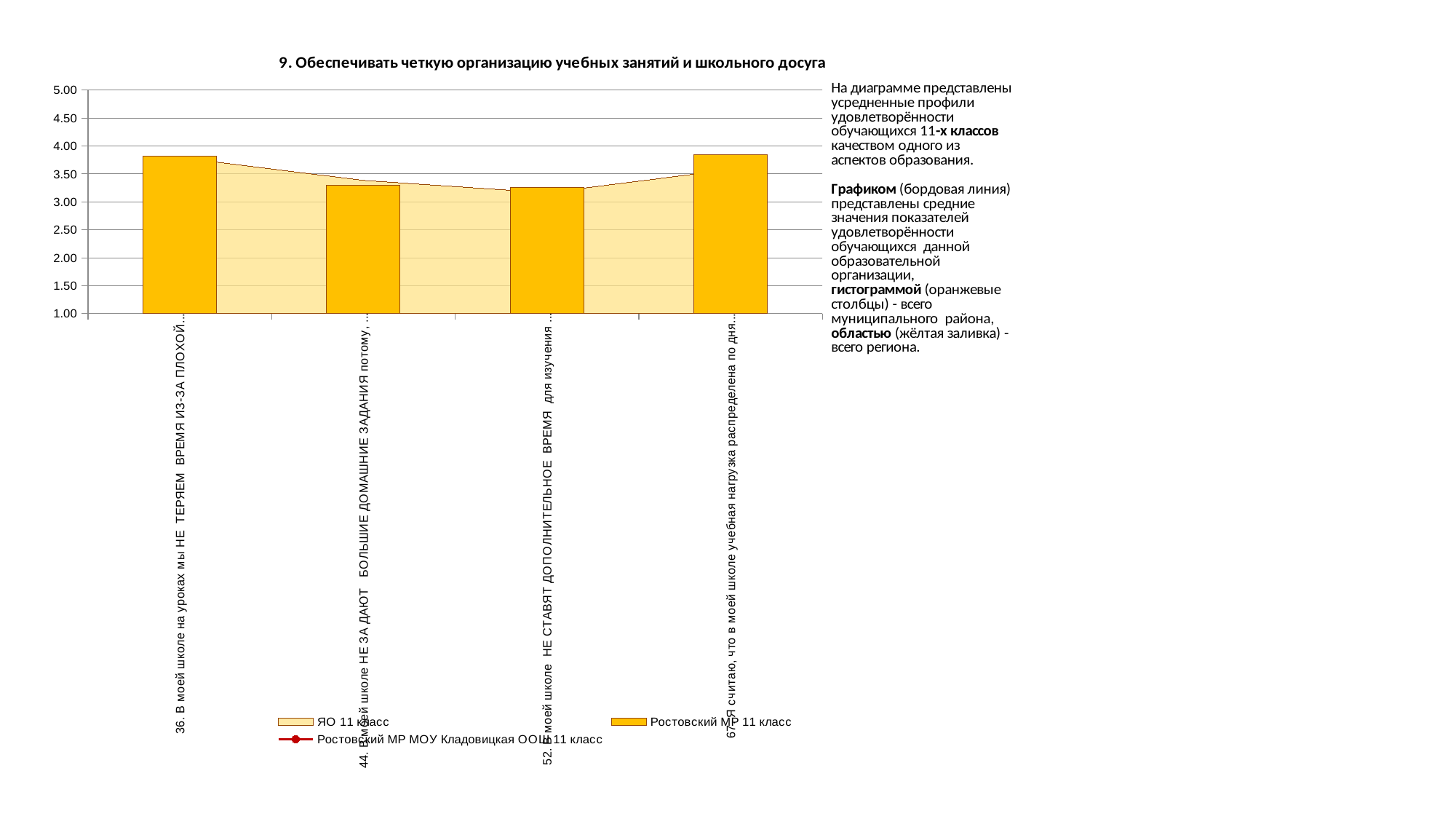
Is the yellow area (ЯО 11 класс) value for statement 36 greater or less than 3.50? greater What is the title of the chart? 9. Обеспечивать четкую организацию учебных занятий и школьного досуга How many categories (statements) are shown along the x axis of the chart? 4 Which orange bar is taller: statement 52 or statement 67? Statement 67 Is the orange bar for statement 52 (В моей школе НЕ СТАВЯТ ДОПОЛНИТЕЛЬНОЕ ВРЕМЯ...) greater or less than 3.50? less Is the orange bar for statement 67 (Я считаю, что в моей школе учебная нагрузка распределена...) greater or less than 3.50? greater Which orange bar is taller: statement 36 or statement 44? Statement 36 Which series is drawn as orange bars according to the legend? Ростовский МР 11 класс How many series does the chart legend list? 3